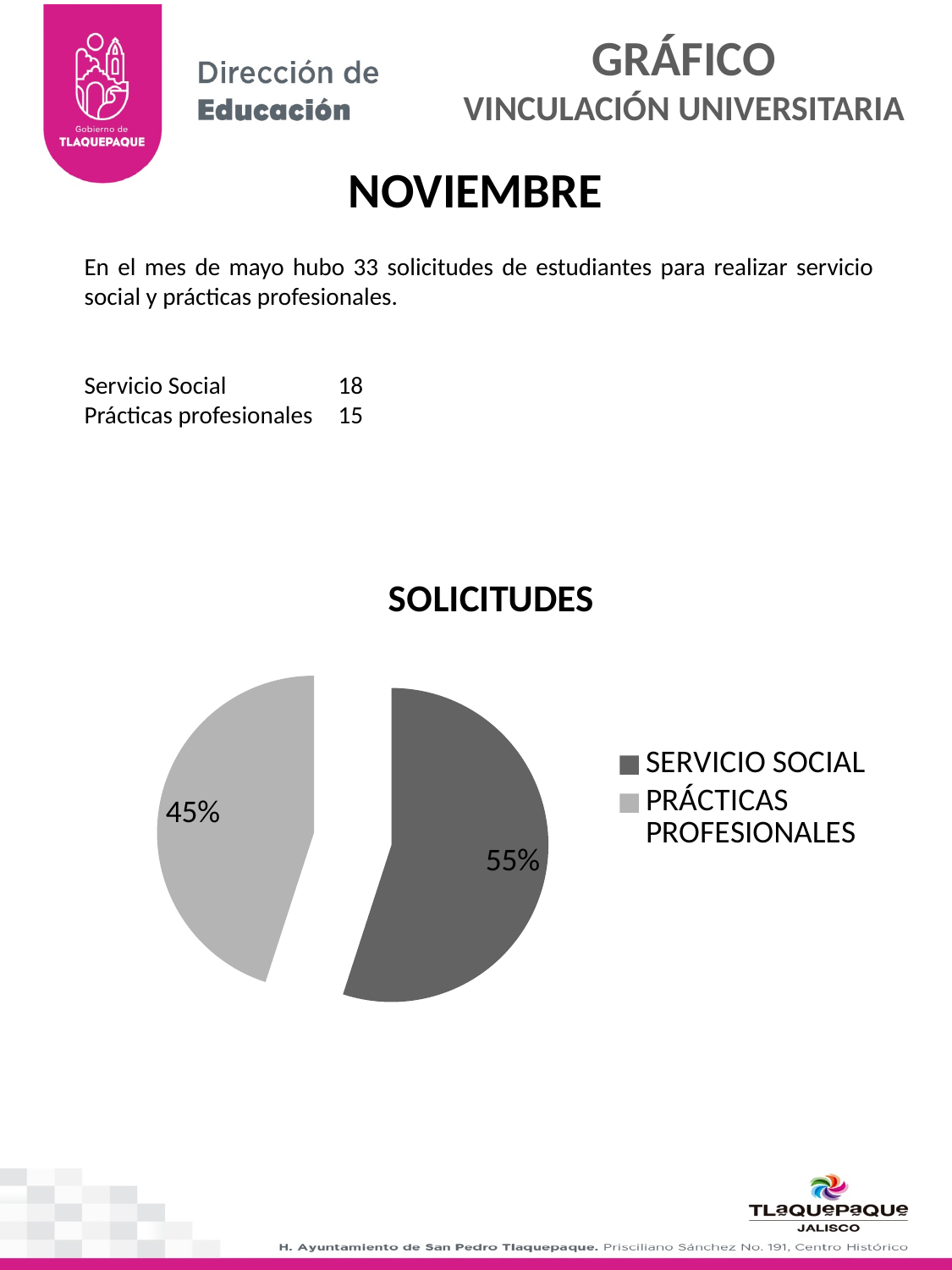
Which legend entry is shown in the darker grey colour? SERVICIO SOCIAL What is the difference in percentage points between the SERVICIO SOCIAL slice and the PRÁCTICAS PROFESIONALES slice? 10% What percentage of the pie does PRÁCTICAS PROFESIONALES represent? 45% Which slice of the pie is the smallest? PRÁCTICAS PROFESIONALES How many slices does the pie chart have? 2 What is the title of the chart? SOLICITUDES Which slice of the pie is the largest? SERVICIO SOCIAL How many entries does the legend list? 2 What type of chart is shown on the slide? pie chart Which is larger, the share for SERVICIO SOCIAL or the share for PRÁCTICAS PROFESIONALES? SERVICIO SOCIAL What percentage of the pie does SERVICIO SOCIAL represent? 55%